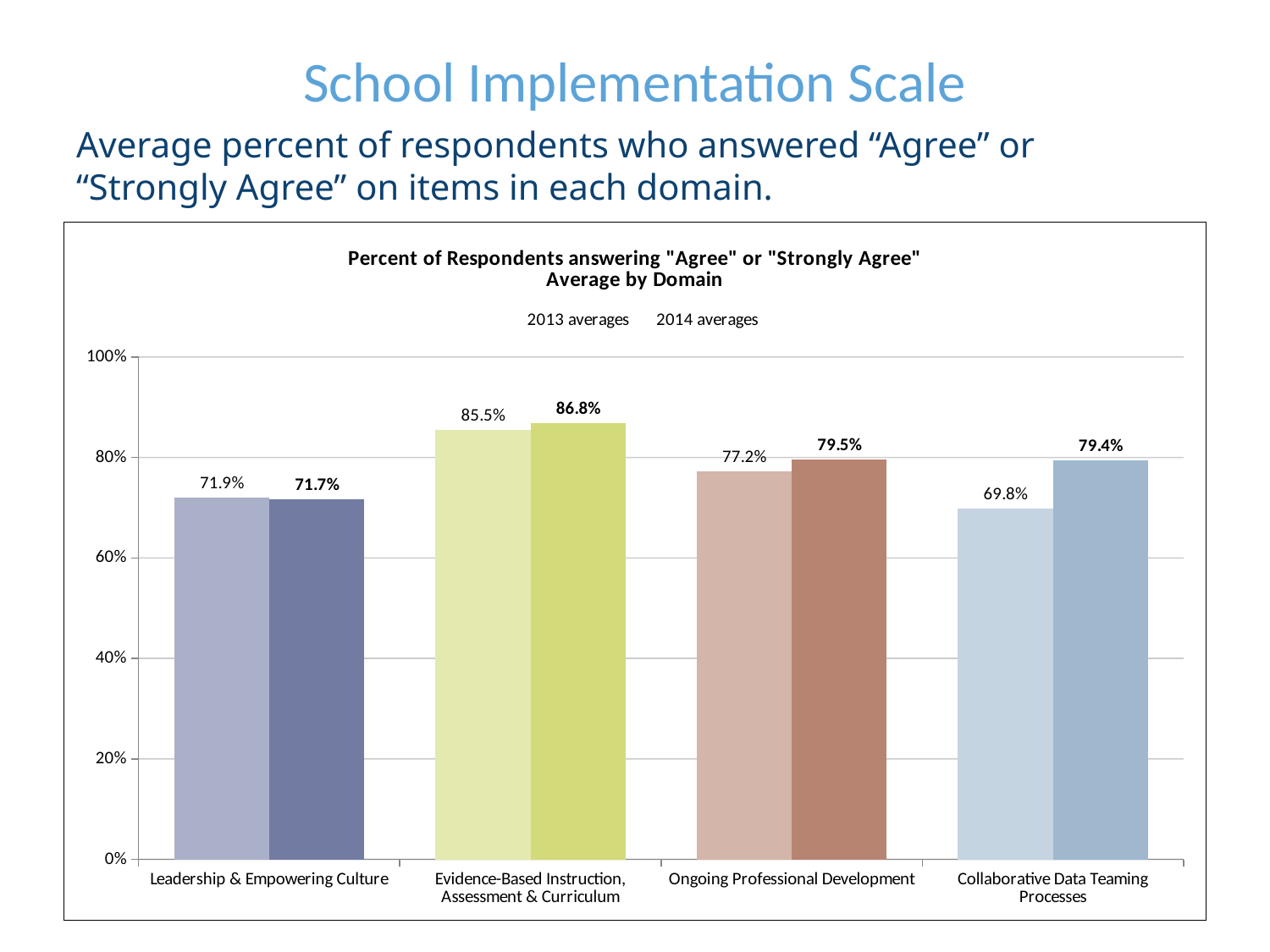
What is the 2014 average for Collaborative Data Teaming Processes? 79.4% What is the difference between the 2014 and 2013 averages for Collaborative Data Teaming Processes? 9.6% How many domains are shown on the x axis? 4 How many series does the legend list? 2 What kind of chart is shown? Bar chart Which domain has the highest 2014 average? Evidence-Based Instruction, Assessment & Curriculum Which domain has the lowest 2013 average? Collaborative Data Teaming Processes Which is larger for Leadership & Empowering Culture, the 2013 average or the 2014 average? 2013 average Is the 2013 average for Collaborative Data Teaming Processes greater or less than 80%? less What is the 2013 average for Evidence-Based Instruction, Assessment & Curriculum? 85.5% What is the 2013 average for Ongoing Professional Development? 77.2% What is the difference between the 2014 and 2013 averages for Evidence-Based Instruction, Assessment & Curriculum? 1.3%